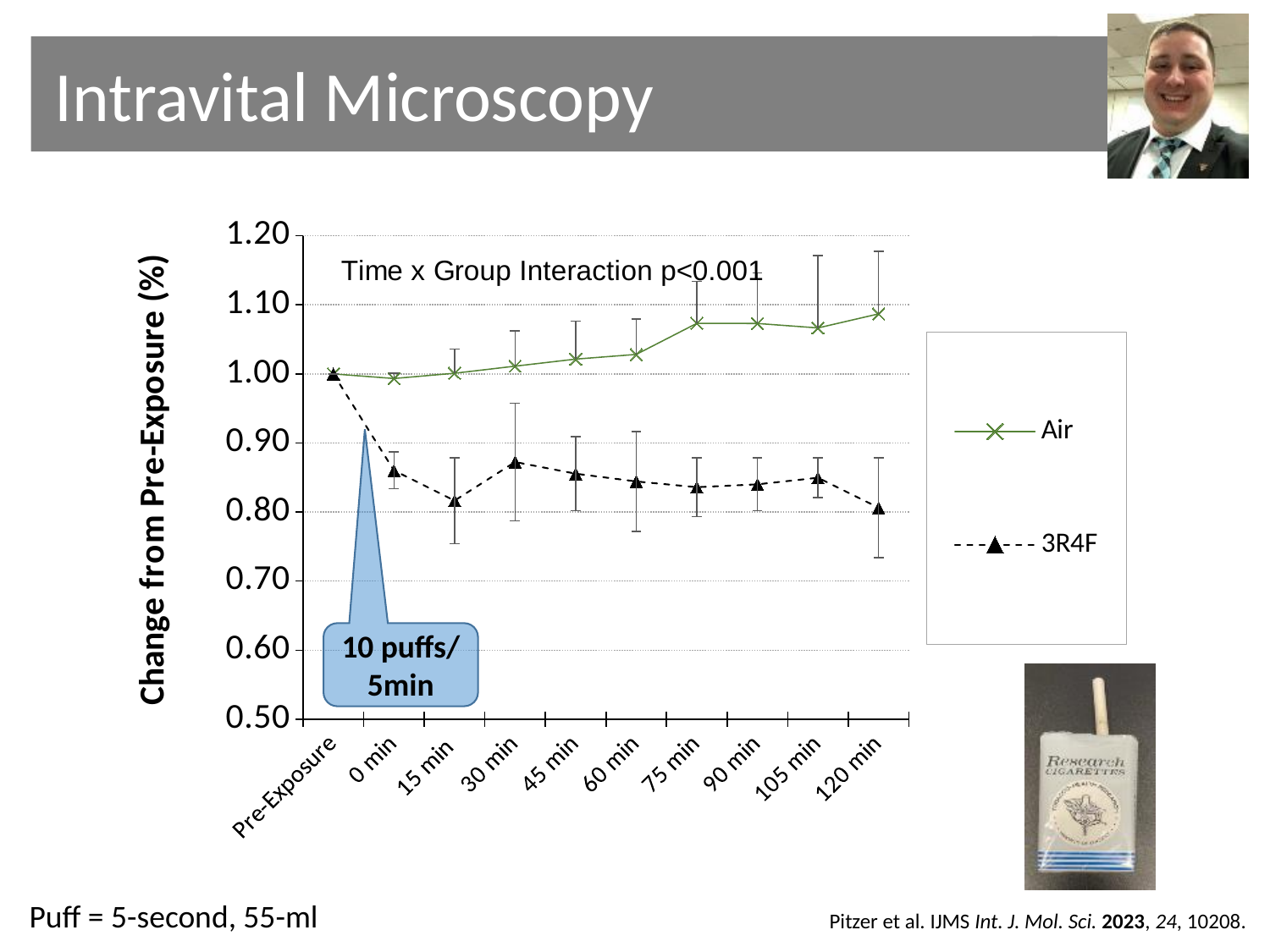
Does the Air series generally rise or fall from Pre-Exposure to 120 min? rise What kind of chart is shown on the slide? line chart What is the value for the Air series at Pre-Exposure? 1.00 How many series does the legend list? 2 At 60 min, which series has the larger value, Air or 3R4F? Air Is the value for 3R4F at 120 min greater or less than 0.90? less Is the value for Air at 120 min greater or less than 1.00? greater Does the 3R4F series rise or fall from Pre-Exposure to 0 min? fall Is the value for 3R4F at 15 min greater or less than 0.90? less What is the y-axis title of the chart? Change from Pre-Exposure (%) What statistical annotation is printed inside the chart area? Time x Group Interaction p<0.001 How many time points are plotted along the x axis? 10